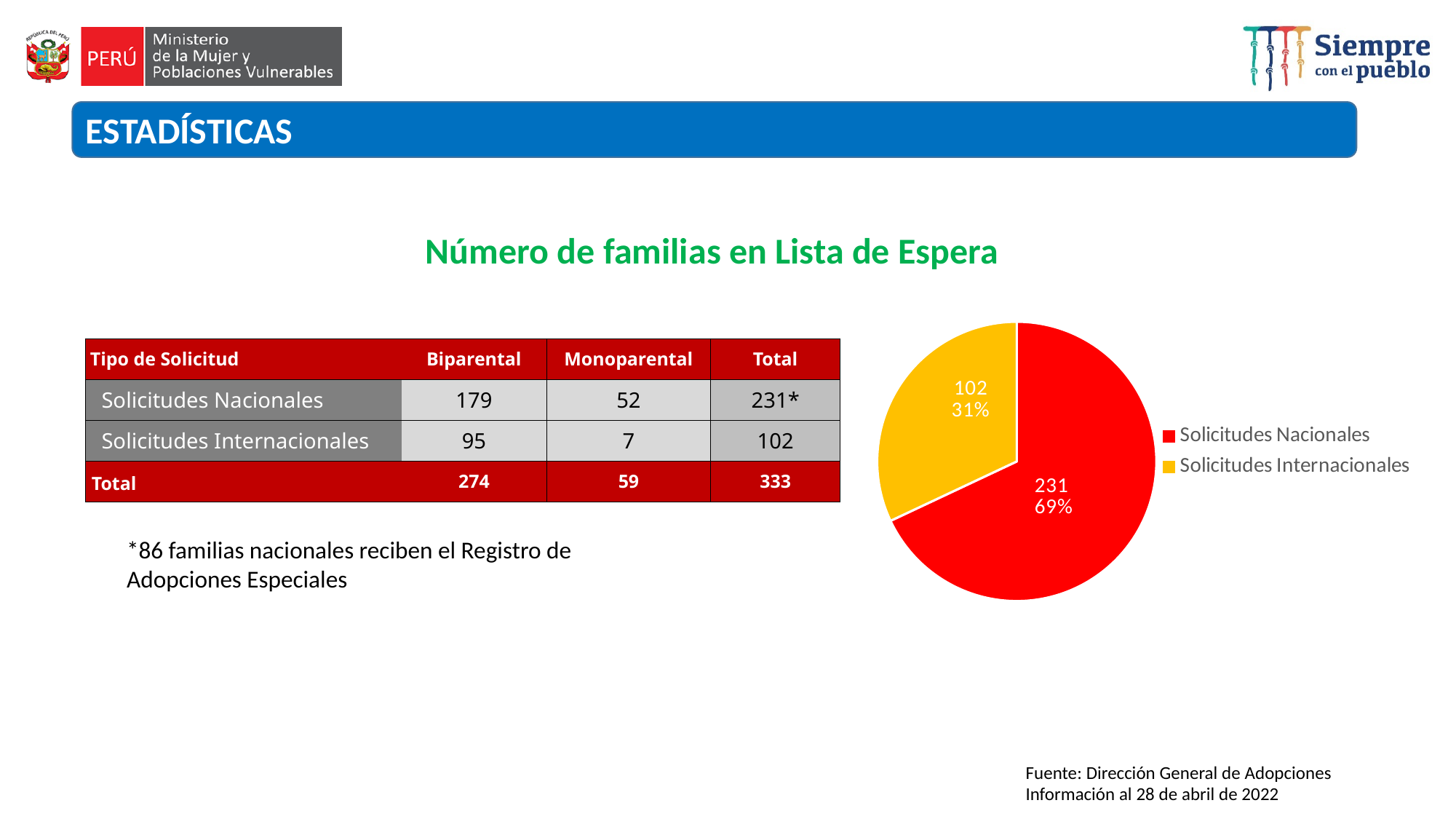
Which category has the largest slice in the pie chart? Solicitudes Nacionales What is the value for Solicitudes Nacionales in the pie chart? 231 What share of the pie does Solicitudes Internacionales represent? 31% What share of the pie does Solicitudes Nacionales represent? 69% What is the difference between the values for Solicitudes Nacionales and Solicitudes Internacionales in the pie chart? 129 How many slices does the pie chart have? 2 What colour is the Solicitudes Internacionales slice in the pie chart? Yellow What kind of chart is shown on the slide? Pie chart Which category has the smallest slice in the pie chart? Solicitudes Internacionales What is the total of the two values shown in the pie chart? 333 What is the value for Solicitudes Internacionales in the pie chart? 102 Which is larger in the pie chart, Solicitudes Nacionales or Solicitudes Internacionales? Solicitudes Nacionales